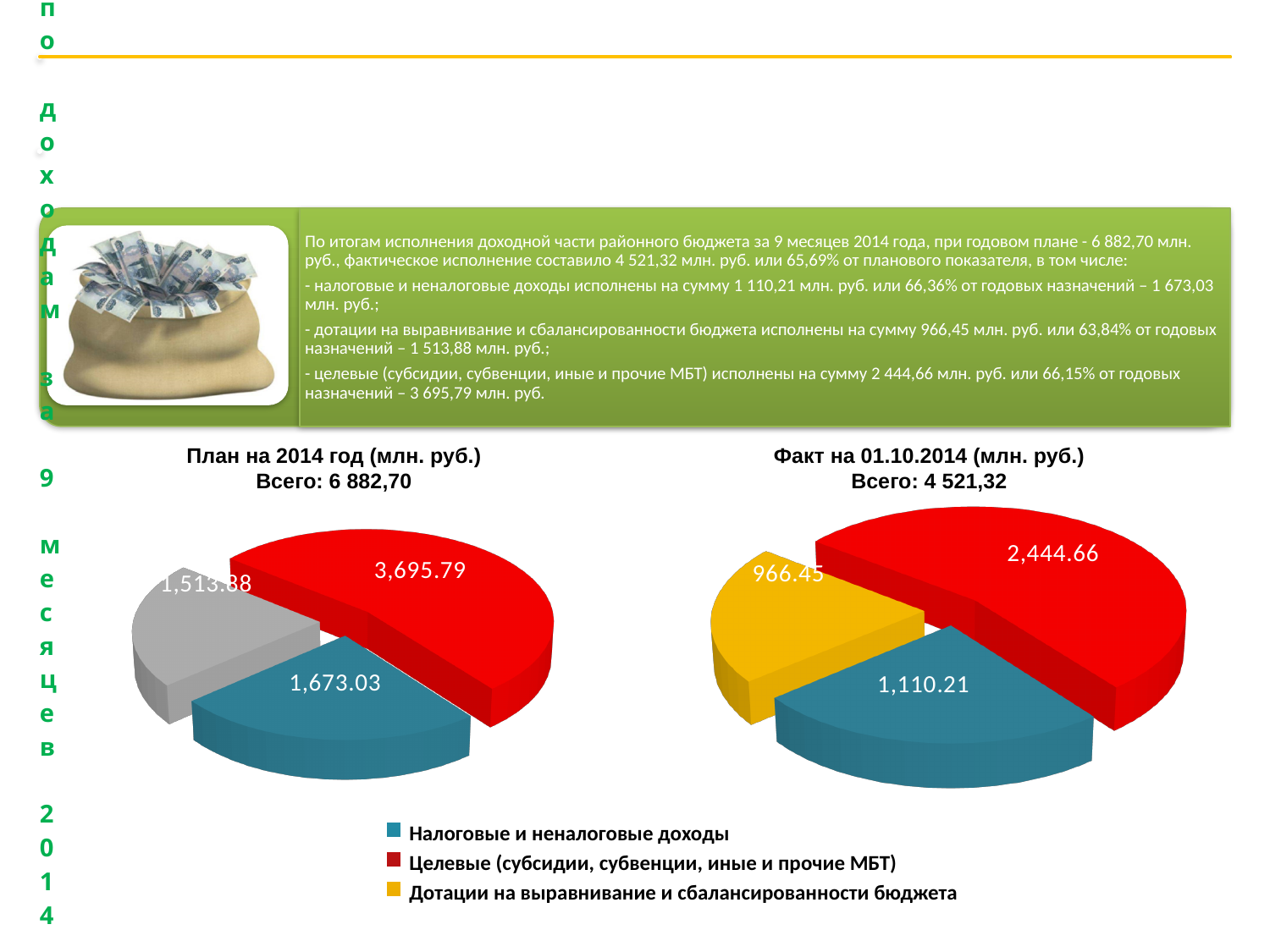
In the chart 'Факт на 01.10.2014 (млн. руб.)', what is the difference between the Целевые slice and the Налоговые и неналоговые доходы slice? 1,334.45 In the chart 'План на 2014 год (млн. руб.)', what is the value for Целевые (субсидии, субвенции, иные и прочие МБТ)? 3,695.79 In the chart 'План на 2014 год (млн. руб.)', what is the value for Налоговые и неналоговые доходы? 1,673.03 In the chart 'Факт на 01.10.2014 (млн. руб.)', what is the value for Налоговые и неналоговые доходы? 1,110.21 In the chart 'Факт на 01.10.2014 (млн. руб.)', what is the value for Дотации на выравнивание и сбалансированности бюджета? 966.45 What type of charts are shown on the slide? Pie charts In the chart 'План на 2014 год (млн. руб.)', what is the smallest slice value? 1,513.88 In the chart 'План на 2014 год (млн. руб.)', what is the difference between the Целевые slice and the Налоговые и неналоговые доходы slice? 2,022.76 In the chart 'Факт на 01.10.2014 (млн. руб.)', which category has the largest slice? Целевые (субсидии, субвенции, иные и прочие МБТ) Which is larger: Налоговые и неналоговые доходы in the 'План на 2014 год' chart or in the 'Факт на 01.10.2014' chart? План на 2014 год How many slices does the chart 'Факт на 01.10.2014 (млн. руб.)' have? 3 How many entries does the shared legend list? 3